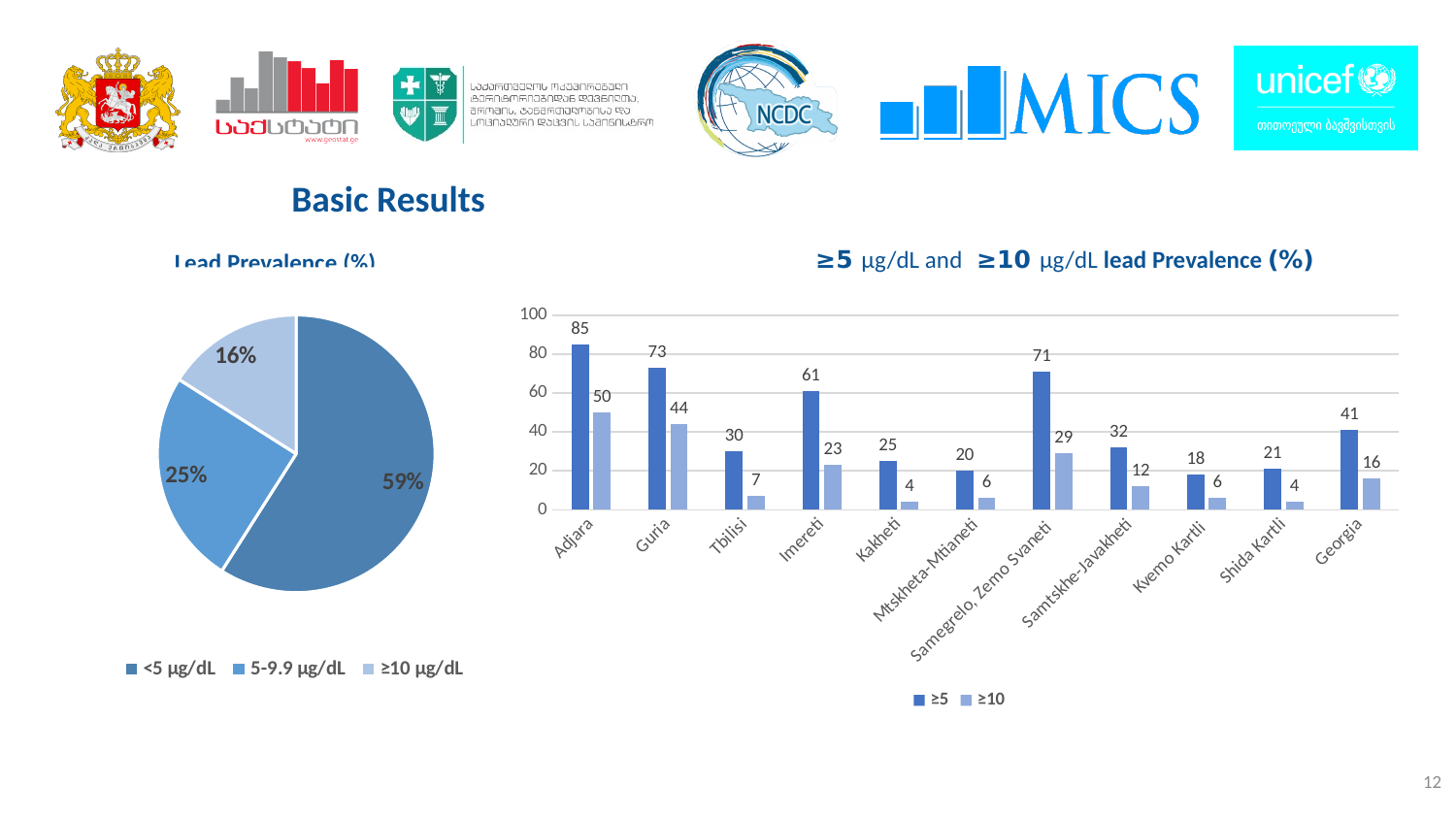
In the pie chart on the left, what share is shown for the ≥10 µg/dL slice? 16% In the bar chart on the right, which region has the highest ≥5 value? Adjara What type of chart is the chart on the left of the slide? Pie chart How many series does the legend of the bar chart on the right list? 2 In the bar chart on the right, what is the ≥5 value for Adjara? 85 How many regions are shown on the x axis of the bar chart on the right? 11 In the bar chart on the right, which is larger: the ≥5 value for Guria or the ≥5 value for Samegrelo, Zemo Svaneti? Guria In the pie chart on the left, which category has the largest slice? <5 µg/dL In the bar chart on the right, what is the difference between the ≥5 and ≥10 values for Imereti? 38 In the bar chart on the right, which region has the lowest ≥5 value? Kvemo Kartli In the bar chart on the right, what is the ≥10 value for Georgia? 16 In the bar chart on the right, what is the ≥10 value for Tbilisi? 7